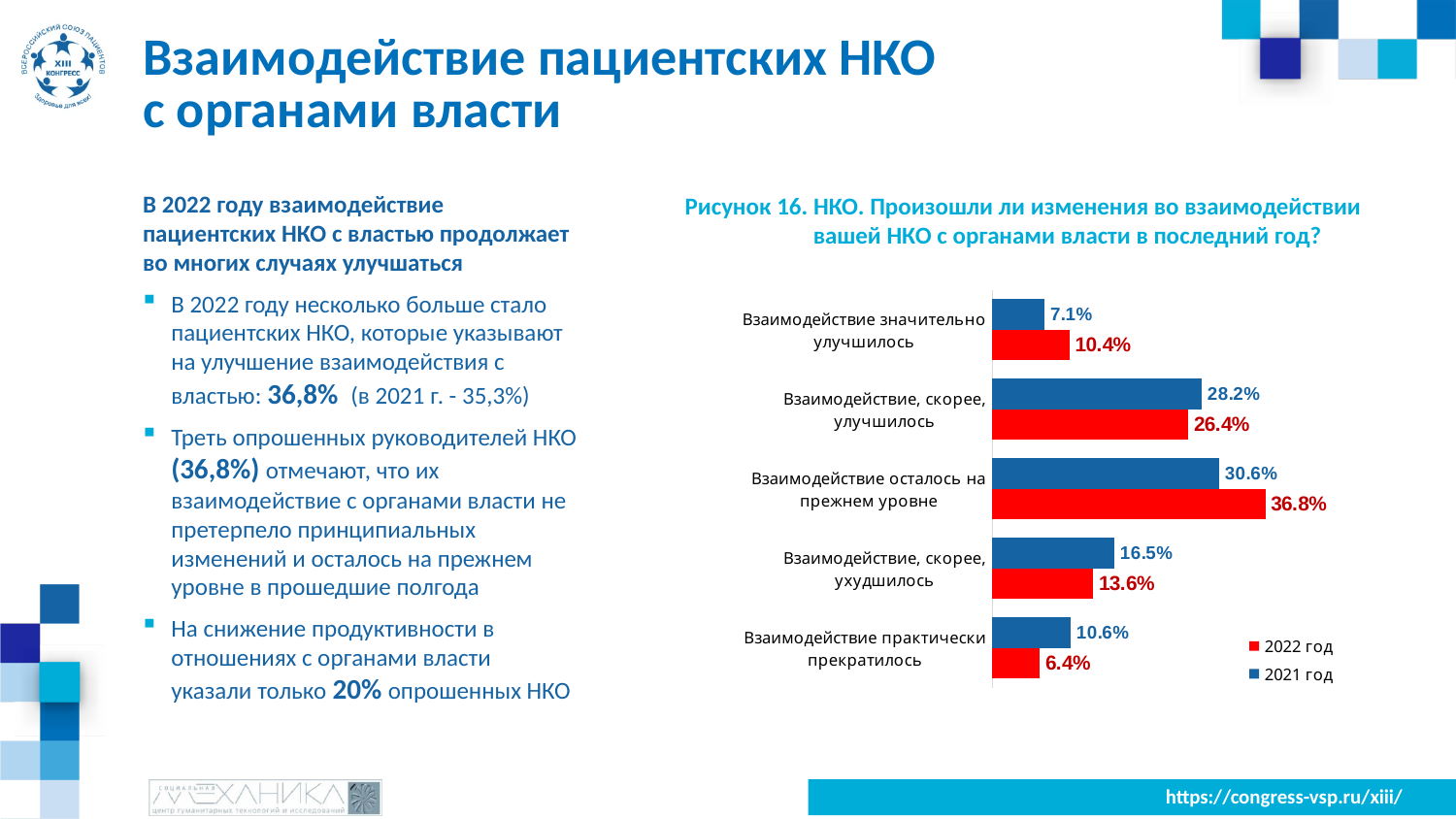
Which colour represents the 2022 год series in the chart? red How many categories are shown in the chart? 5 Which category has the lowest value in the 2021 год series? Взаимодействие значительно улучшилось How many series does the legend list? 2 For "Взаимодействие, скорее, ухудшилось", which series has the larger value, 2022 год or 2021 год? 2021 год Which category has the highest value in the 2022 год series? Взаимодействие осталось на прежнем уровне What is the value for "Взаимодействие осталось на прежнем уровне" in the 2022 год series? 36.8% What type of chart is shown on the slide? bar chart What is the difference between the 2022 год and 2021 год values for "Взаимодействие осталось на прежнем уровне"? 6.2% What is the difference between the 2021 год and 2022 год values for "Взаимодействие практически прекратилось"? 4.2% What is the value for "Взаимодействие значительно улучшилось" in the 2021 год series? 7.1% What is the value for "Взаимодействие практически прекратилось" in the 2022 год series? 6.4%